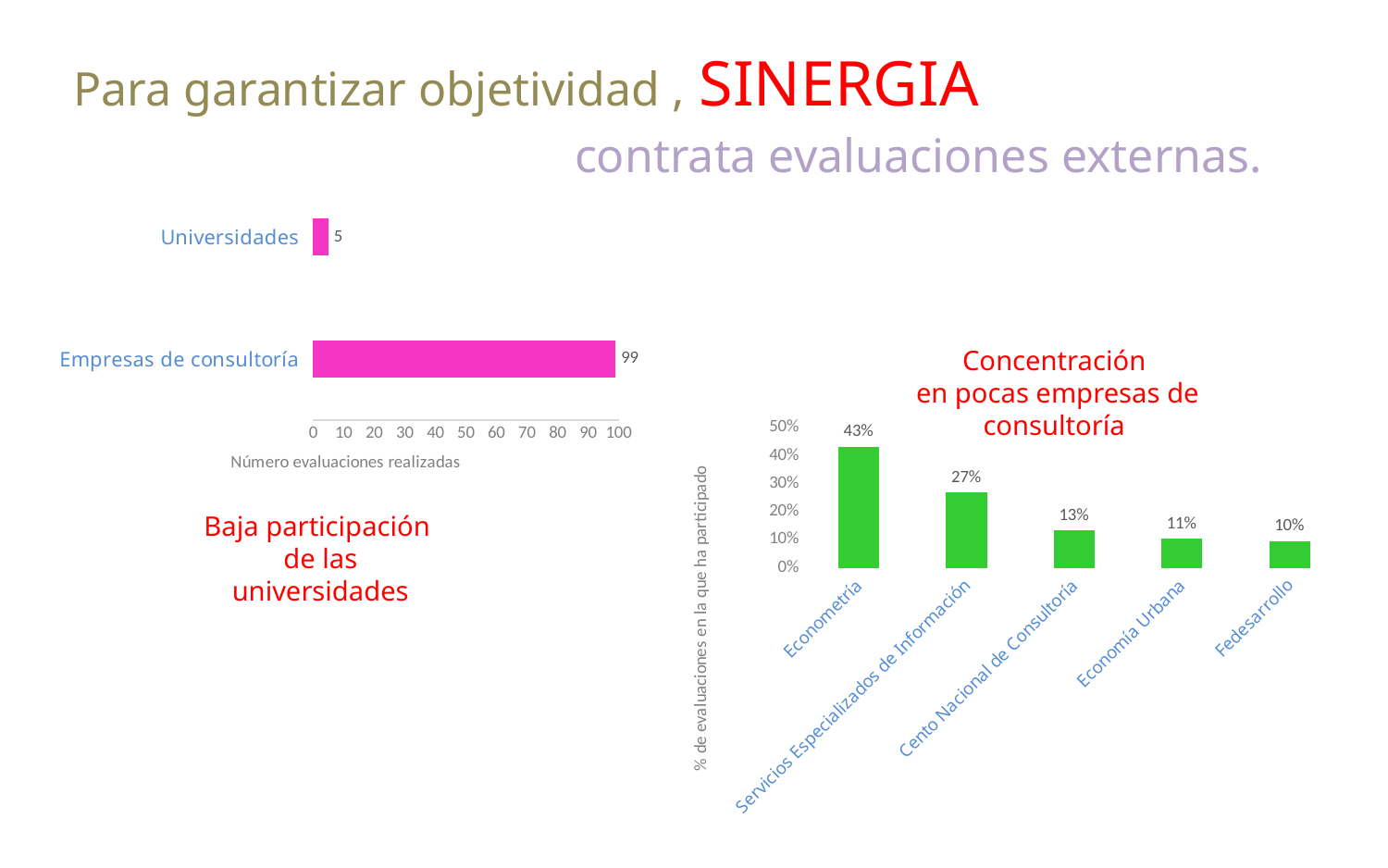
In the chart titled 'Concentración en pocas empresas de consultoría', which category has the lowest value? Fedesarrollo In the chart titled 'Concentración en pocas empresas de consultoría', what is the value for Servicios Especializados de Información? 27% In the chart titled 'Concentración en pocas empresas de consultoría', which category has the highest value? Econometría In the chart on the left, what is the label of the horizontal axis? Número evaluaciones realizadas In the chart on the left, what is the difference between the number of evaluations by Empresas de consultoría and by Universidades? 94 In the chart titled 'Concentración en pocas empresas de consultoría', what is the value for Econometría? 43% In the chart titled 'Concentración en pocas empresas de consultoría', do the values rise or fall from left to right? Fall In the chart on the left, how many evaluations were carried out by Empresas de consultoría? 99 In the chart titled 'Concentración en pocas empresas de consultoría', how many categories are shown? 5 In the chart on the left, how many evaluations were carried out by Universidades? 5 In the chart on the left, what kind of chart is shown? Bar chart In the chart titled 'Concentración en pocas empresas de consultoría', what is the difference between Econometría and Cento Nacional de Consultoría? 30%